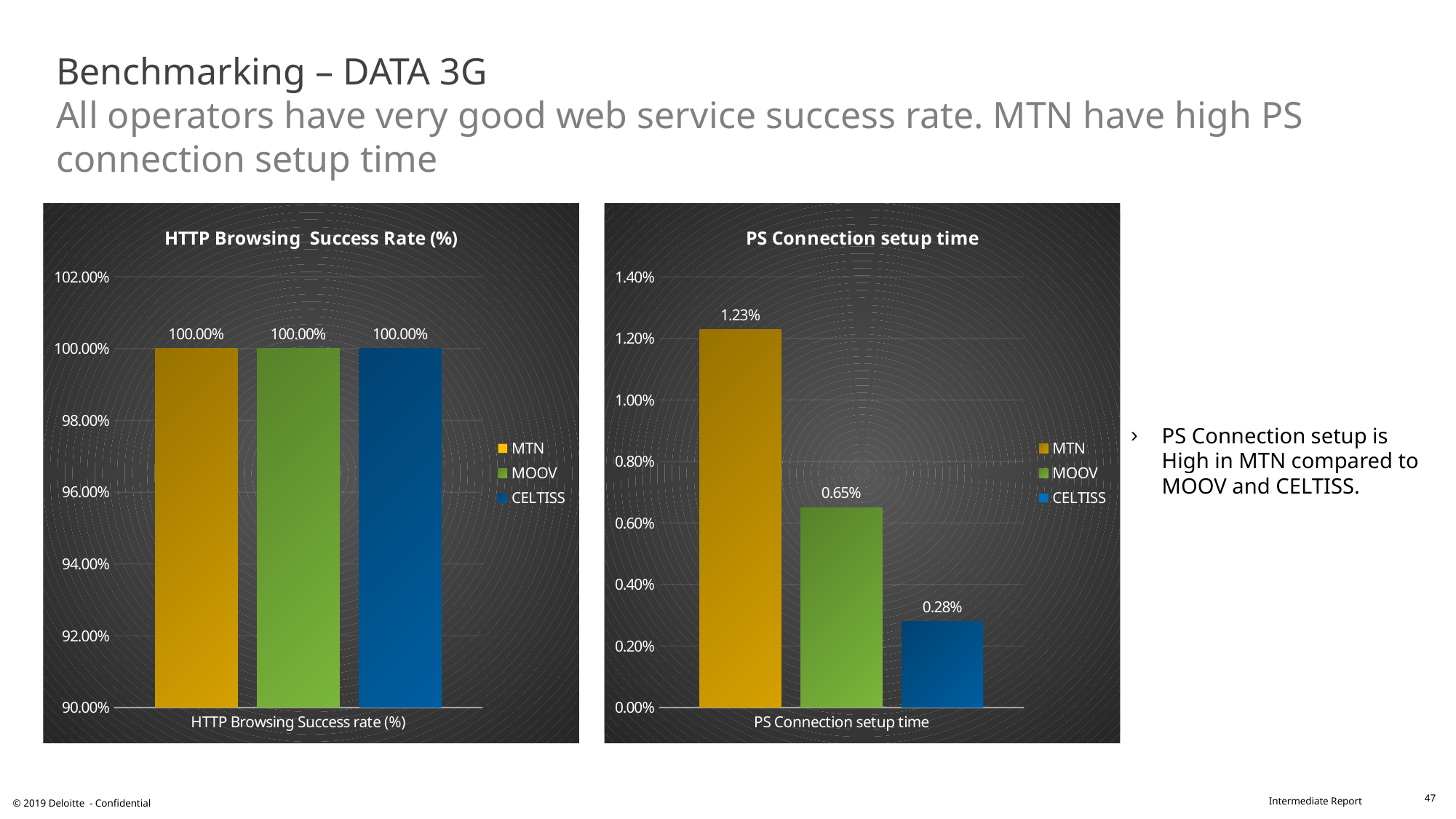
What kind of chart is the 'PS Connection setup time' chart? Bar chart In the 'PS Connection setup time' chart, which operator has the highest value? MTN In the 'PS Connection setup time' chart, is the value for MTN greater or less than 1.00%? greater How many series does the legend of the 'HTTP Browsing Success Rate (%)' chart list? 3 In the 'HTTP Browsing Success Rate (%)' chart, what is the value for MOOV? 100.00% In the 'PS Connection setup time' chart, which operator has the lowest value? CELTISS In the 'PS Connection setup time' chart, what is the value for MOOV? 0.65% In the 'PS Connection setup time' chart, what is the value for CELTISS? 0.28% In the 'PS Connection setup time' chart, what is the value for MTN? 1.23% In the 'PS Connection setup time' chart, what is the difference between the MTN and MOOV values? 0.58% In the 'PS Connection setup time' chart, what colour is the MOOV bar? Green In the 'PS Connection setup time' chart, which is larger, the value for MOOV or the value for CELTISS? MOOV